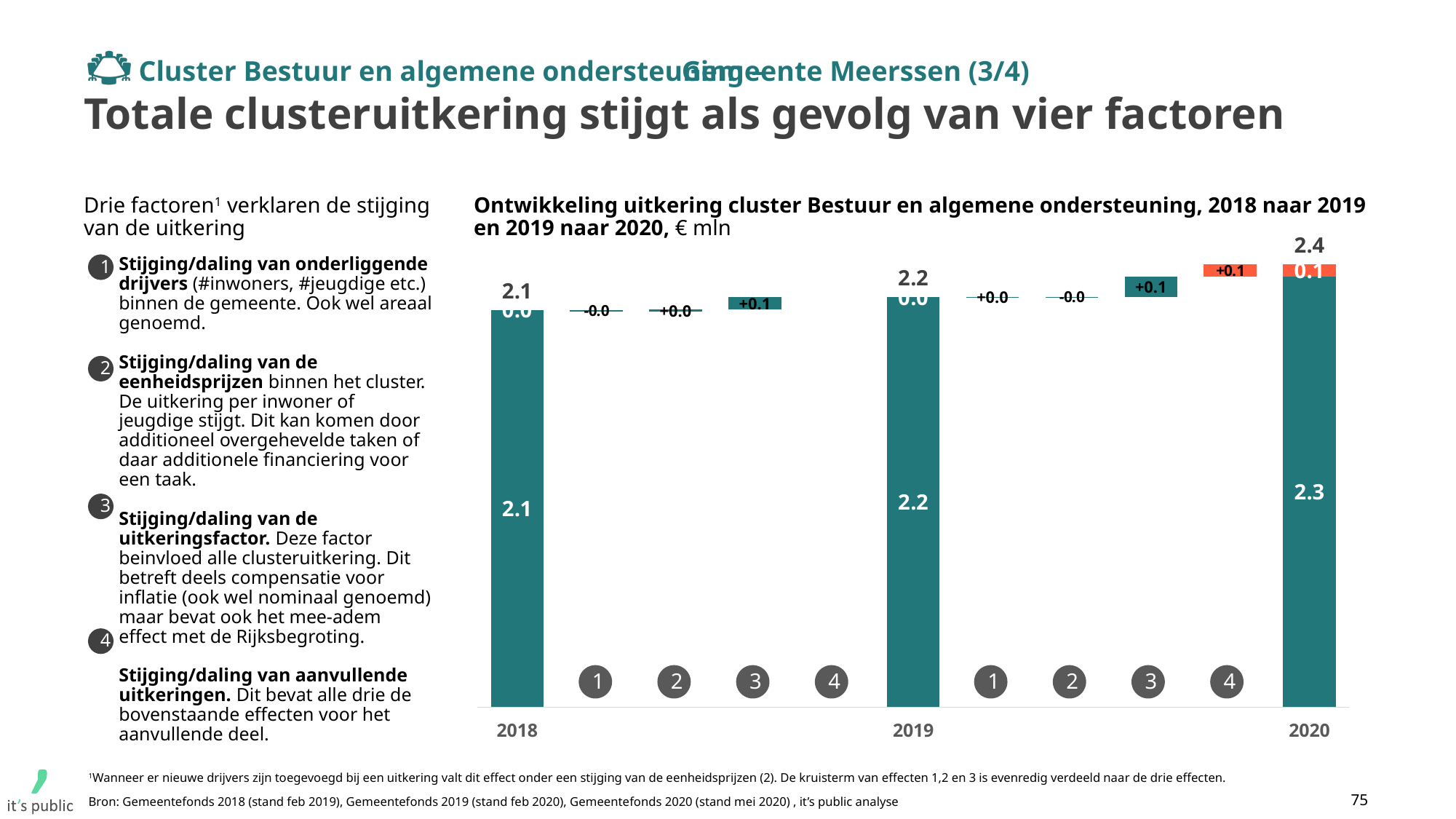
What is the effect of factor 3 (uitkeringsfactor) from 2018 to 2019? +0.1 In what unit are the values in the chart expressed? € mln Which year has the lowest total uitkering? 2018 What is the effect of factor 4 (aanvullende uitkeringen) from 2019 to 2020? +0.1 Do the yearly totals rise or fall from 2018 to 2020? rise What is the value of the lower (teal) segment of the 2020 bar? 2.3 What is the difference between the 2020 total and the 2018 total? 0.3 What is the total uitkering shown for 2019? 2.2 Which year has the highest total uitkering? 2020 Is the total for 2019 larger or smaller than the total for 2018? larger What is the total uitkering shown for 2018? 2.1 What is the total uitkering shown for 2020? 2.4